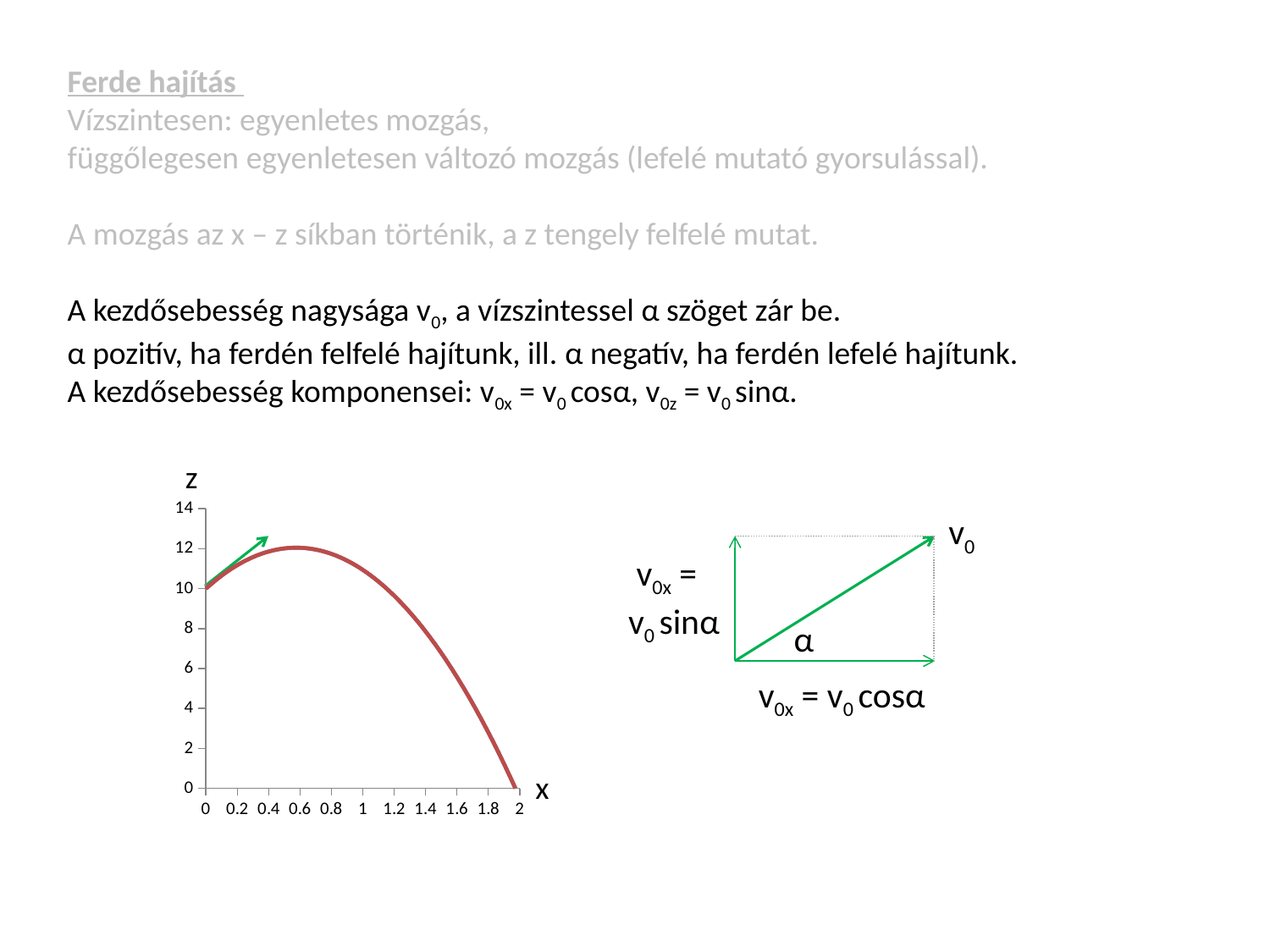
Is the value of z at x = 1 greater or less than 10? greater What is the label of the horizontal axis of the chart? x What is the value of z where the curve starts at x = 0? 10 Does the curve rise or fall as x increases from 1 to 2? fall Which has the larger z value on the curve: x = 0.6 or x = 1.8? x = 0.6 Is the value of z at x = 1.6 greater or less than 8? less How many tick labels are shown on the horizontal (x) axis? 11 What kind of chart is shown on the slide? line chart What is the label of the vertical axis of the chart? z Is the value of z at x = 1.8 greater or less than 6? less What is the highest value shown on the vertical (z) axis? 14